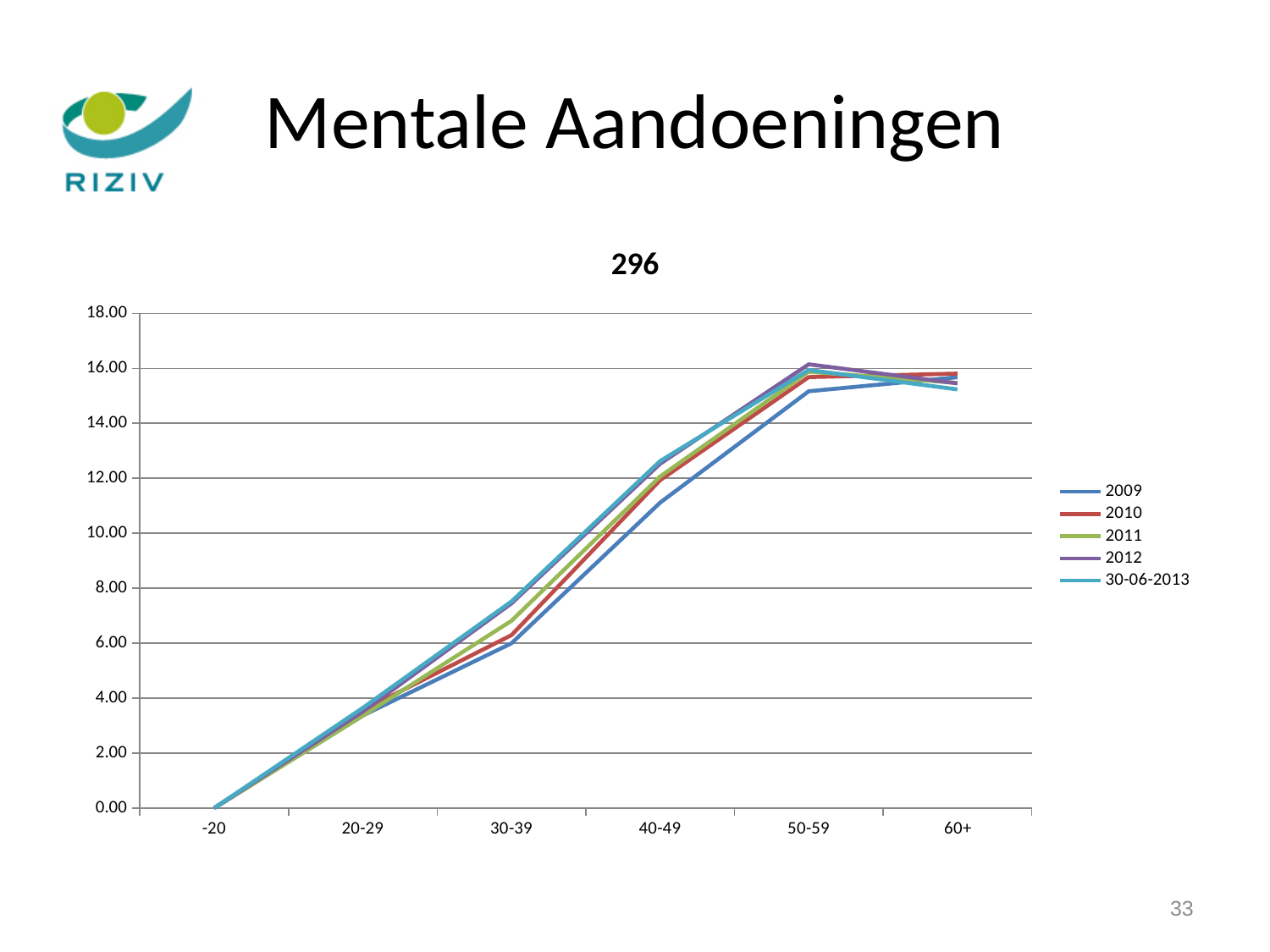
What is the value for the 2009 series at the -20 category? 0.00 How many age categories are shown on the x axis? 6 How many series does the legend list? 5 Do the values for the 2010 series rise or fall from -20 to 50-59? rise Which age category has the lowest value for the 2012 series? -20 What kind of chart is shown on the slide? line chart Is the value for 2012 at 50-59 greater or less than 14.00? greater Is the value for 30-06-2013 at 60+ greater or less than 16.00? less At the 30-39 category, which series has the larger value: 2009 or 30-06-2013? 30-06-2013 What is the title of the chart? 296 Is the value for 30-06-2013 at 30-39 greater or less than 8.00? less